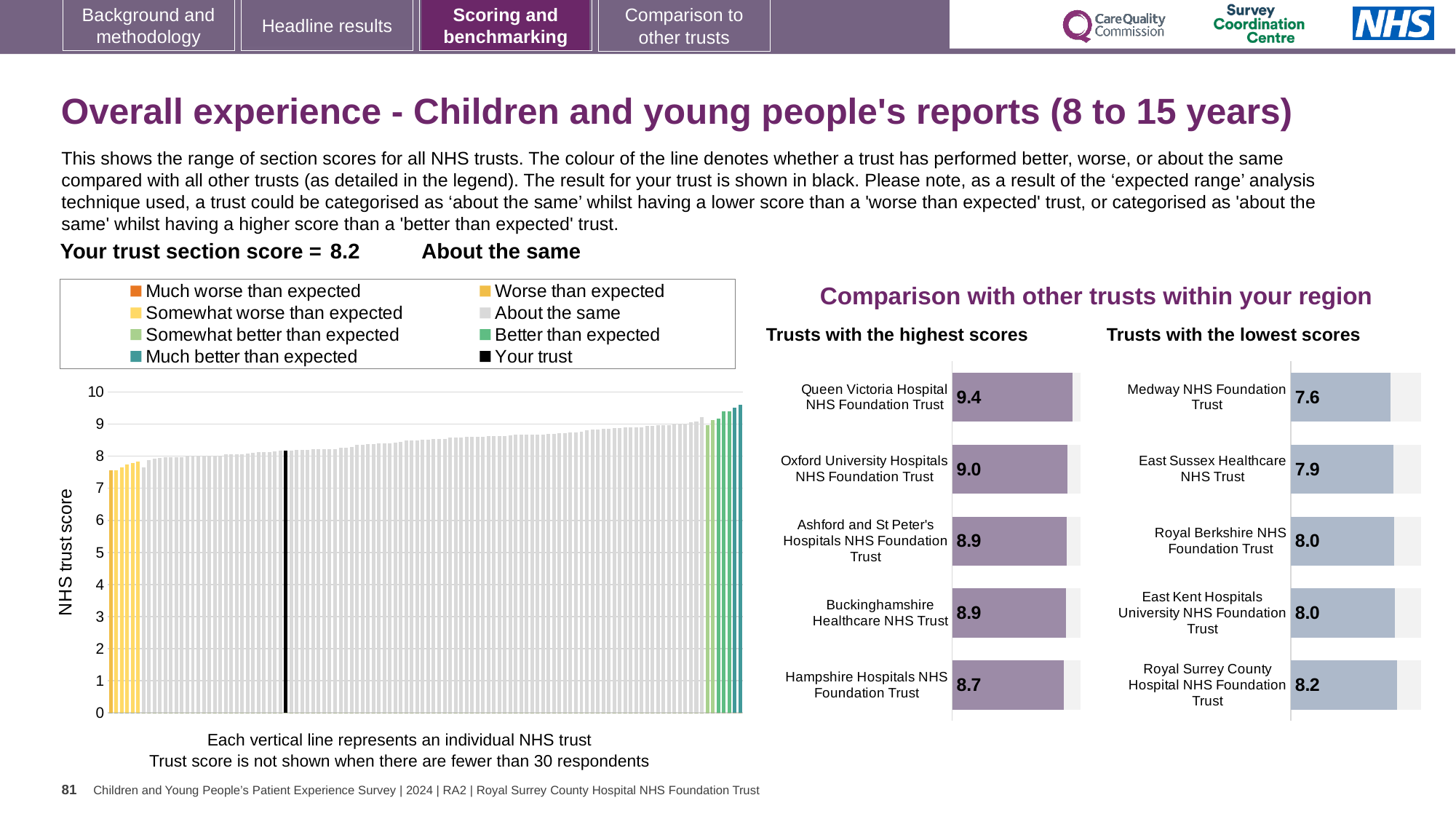
In the 'Trusts with the highest scores' chart, what is the score for Queen Victoria Hospital NHS Foundation Trust? 9.4 What kind of chart is the large chart on the left showing NHS trust scores? Bar chart In the 'Trusts with the highest scores' chart, what is the difference between the scores of Queen Victoria Hospital NHS Foundation Trust and Hampshire Hospitals NHS Foundation Trust? 0.7 In the 'Trusts with the highest scores' chart, how many trusts are shown? 5 In the 'Trusts with the lowest scores' chart, what is the score for Medway NHS Foundation Trust? 7.6 In the 'Trusts with the highest scores' chart, which trust has the lowest score? Hampshire Hospitals NHS Foundation Trust In the large chart on the left, do the trust scores rise or fall from left to right? Rise In the large chart on the left, is the value of the leftmost bar greater or less than 8? less In the 'Trusts with the lowest scores' chart, which trust has the highest score? Royal Surrey County Hospital NHS Foundation Trust How many entries does the legend of the large chart on the left list? 8 In the 'Trusts with the lowest scores' chart, which has the larger score: East Sussex Healthcare NHS Trust or Medway NHS Foundation Trust? East Sussex Healthcare NHS Trust In the 'Trusts with the lowest scores' chart, what is the difference between the scores of Royal Surrey County Hospital NHS Foundation Trust and Medway NHS Foundation Trust? 0.6